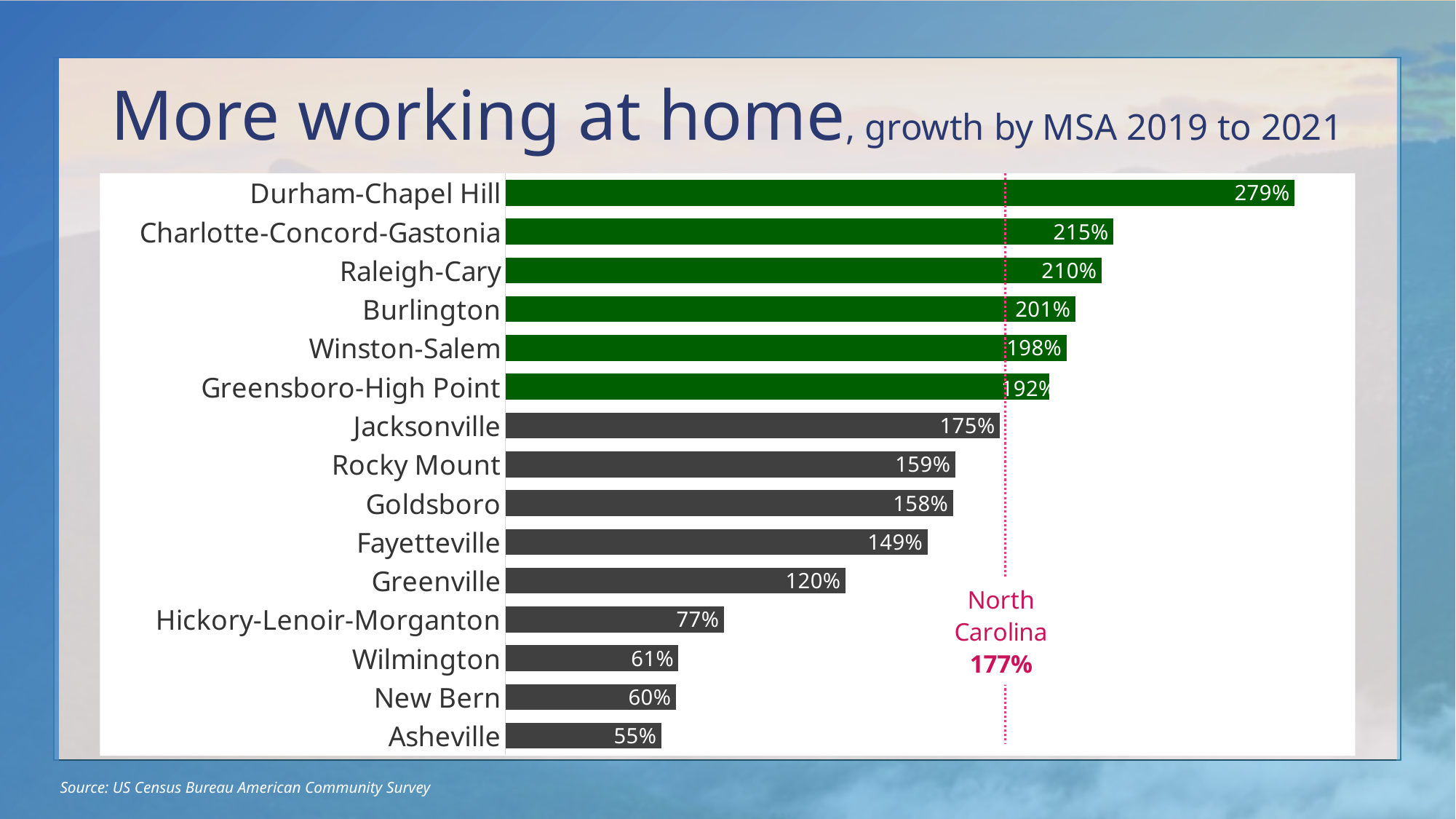
How many bars are coloured green? 6 Which MSA has the lowest growth? Asheville Which MSA has the highest growth? Durham-Chapel Hill Which is larger, the value for Jacksonville or the value for Greenville? Jacksonville What is the difference between the values for Charlotte-Concord-Gastonia and Raleigh-Cary? 5% What kind of chart is shown on the slide? Bar chart What is the growth value for Fayetteville? 149% What is the growth value for Wilmington? 61% What is the difference between the values for Durham-Chapel Hill and Asheville? 224% What is the North Carolina value marked by the dotted reference line? 177% How many MSAs are shown in the chart? 15 What is the growth value for Durham-Chapel Hill? 279%